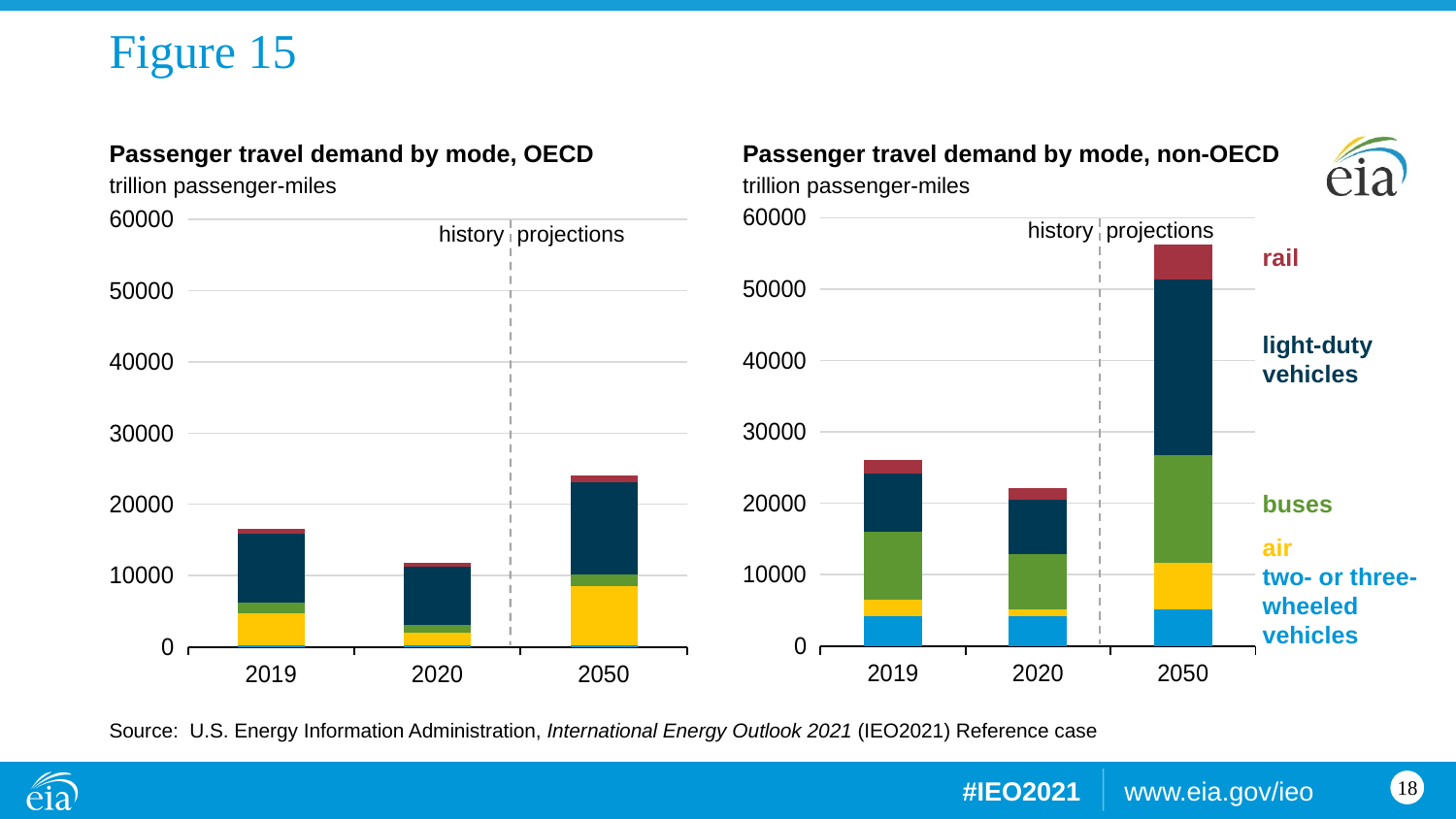
In the 'Passenger travel demand by mode, OECD' chart, which year has the tallest total bar? 2050 How many travel modes are listed in the legend of the 'Passenger travel demand by mode, non-OECD' chart? 5 In the 'Passenger travel demand by mode, non-OECD' chart, is the total bar for 2050 greater or less than 50000? greater What kind of chart is the 'Passenger travel demand by mode, OECD' chart? stacked bar chart In the 'Passenger travel demand by mode, non-OECD' chart, which year has the shortest total bar? 2020 What unit is used on the y axis of both charts? trillion passenger-miles In the 'Passenger travel demand by mode, non-OECD' chart, which total bar is larger, 2050 or 2019? 2050 In the 'Passenger travel demand by mode, OECD' chart, is the total bar for 2050 greater or less than 20000? greater In the 'Passenger travel demand by mode, OECD' chart, which total bar is larger, 2019 or 2020? 2019 In the 'Passenger travel demand by mode, non-OECD' chart, which travel mode is shown in the dark blue segment at the top of the stack below rail? light-duty vehicles How many years are shown on the x axis of the 'Passenger travel demand by mode, non-OECD' chart? 3 In the 'Passenger travel demand by mode, non-OECD' chart, is the total bar for 2020 greater or less than 30000? less